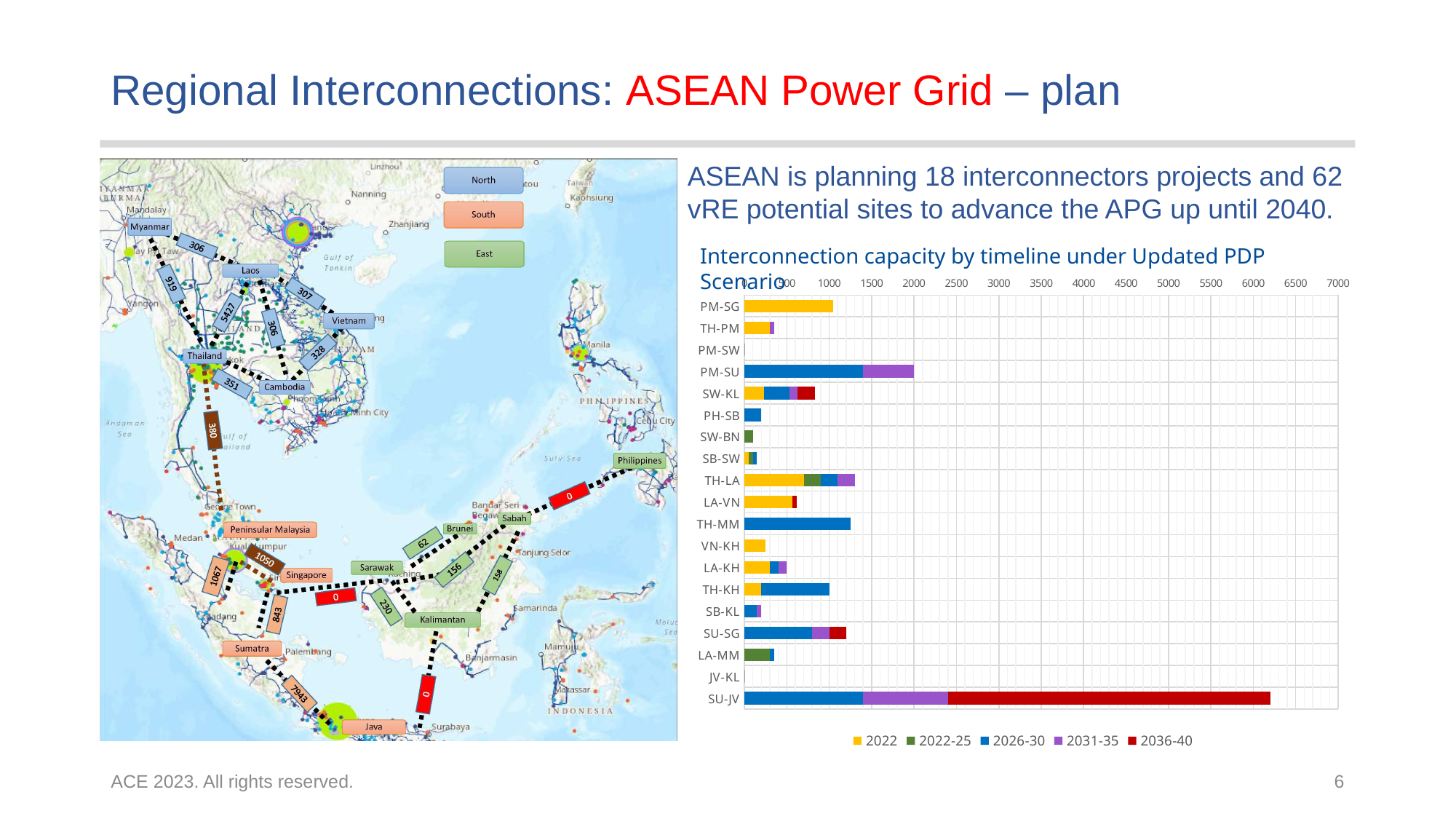
What is the title of the chart? Interconnection capacity by timeline under Updated PDP Scenario Which has the larger total capacity, PM-SU or SW-KL? PM-SU How many series does the chart legend list? 5 What kind of chart is used to show interconnection capacity by timeline? Bar chart Is the total value for SU-JV greater or less than 5000? greater Which has the larger total capacity, PM-SG or TH-PM? PM-SG Is the total value for TH-MM greater or less than 500? greater Which timeline period is shown in red in the chart legend? 2036-40 How many interconnection categories are listed on the vertical axis of the chart? 19 Which interconnection has the largest total capacity in the chart? SU-JV Is the total value for PM-SU greater or less than 1500? greater